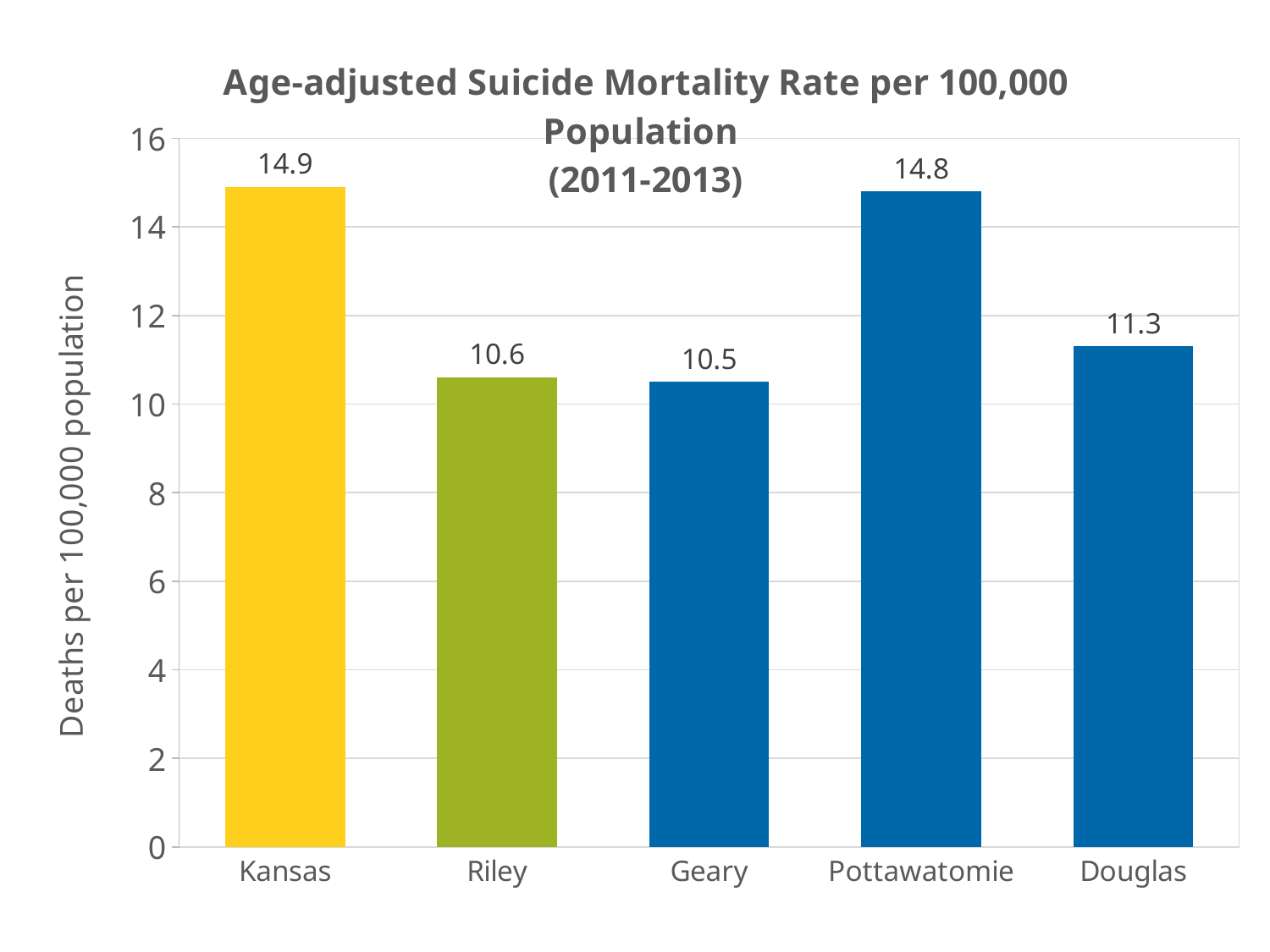
Which category has the highest value? Kansas Which is larger, the value for Pottawatomie or the value for Riley? Pottawatomie What is the difference between the values for Kansas and Douglas? 3.6 What is the difference between the values for Pottawatomie and Geary? 4.3 Which category has the lowest value? Geary What kind of chart is shown on the slide? bar chart How many categories are shown on the x axis? 5 Is the value for Douglas greater or less than 12? less What is the value shown for Riley? 10.6 What is the label of the vertical axis? Deaths per 100,000 population What is the value shown for Douglas? 11.3 What is the age-adjusted suicide mortality rate for Kansas? 14.9